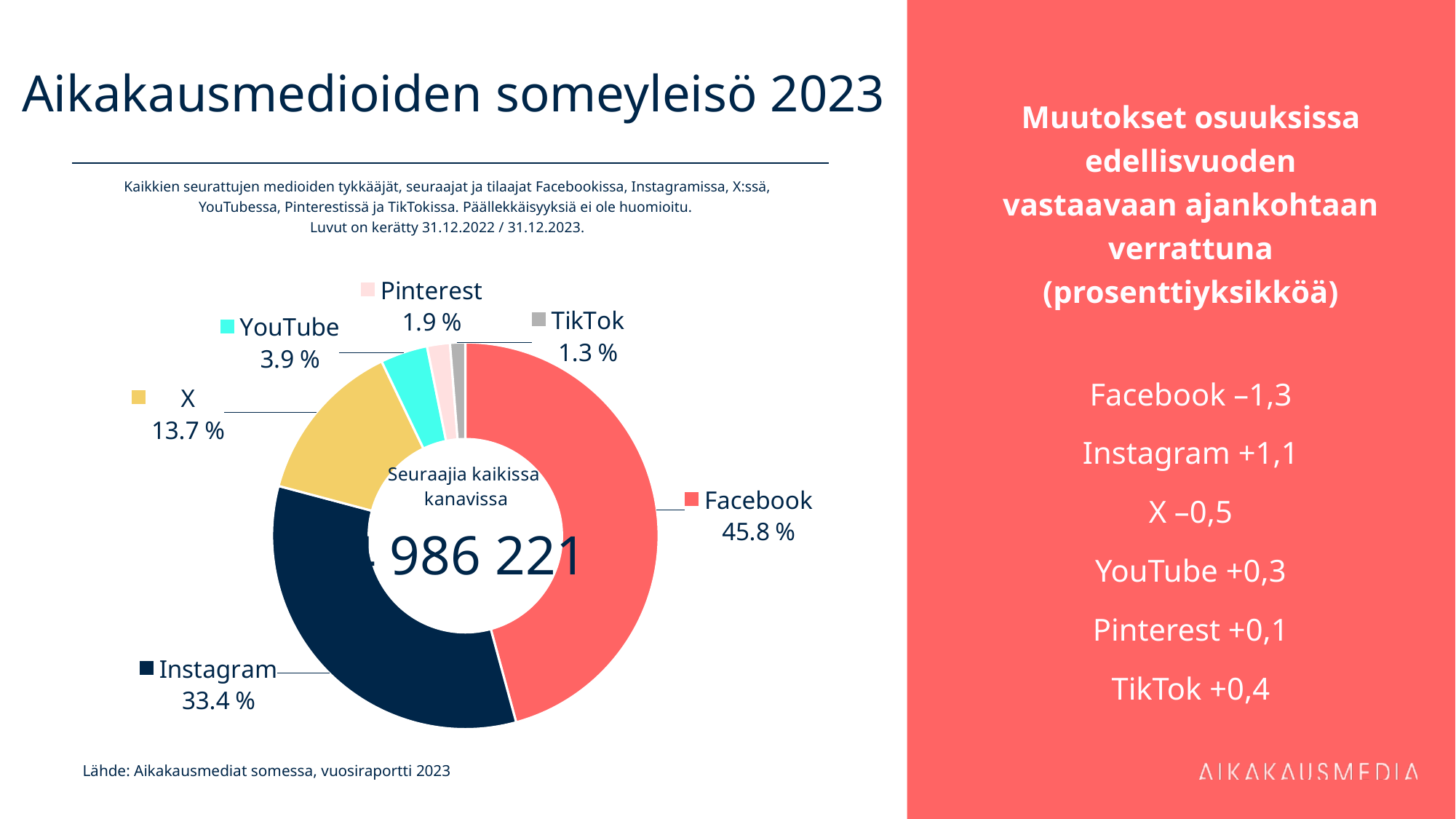
Which has a larger share, YouTube or Pinterest? YouTube How many platforms (slices) are shown in the chart? 6 What share of the donut chart does Facebook hold? 45.8 % What is the value shown for Instagram in the donut chart? 33.4 % What is the value shown for TikTok? 1.3 % Which platform has the largest share in the chart? Facebook Which platform has the smallest share in the chart? TikTok What is the difference in percentage points between Facebook and Instagram? 12.4 What percentage is shown for X in the chart? 13.7 % What type of chart is shown on the slide? Donut (pie) chart What is the combined share of X and YouTube? 17.6 % What is the value shown for YouTube? 3.9 %